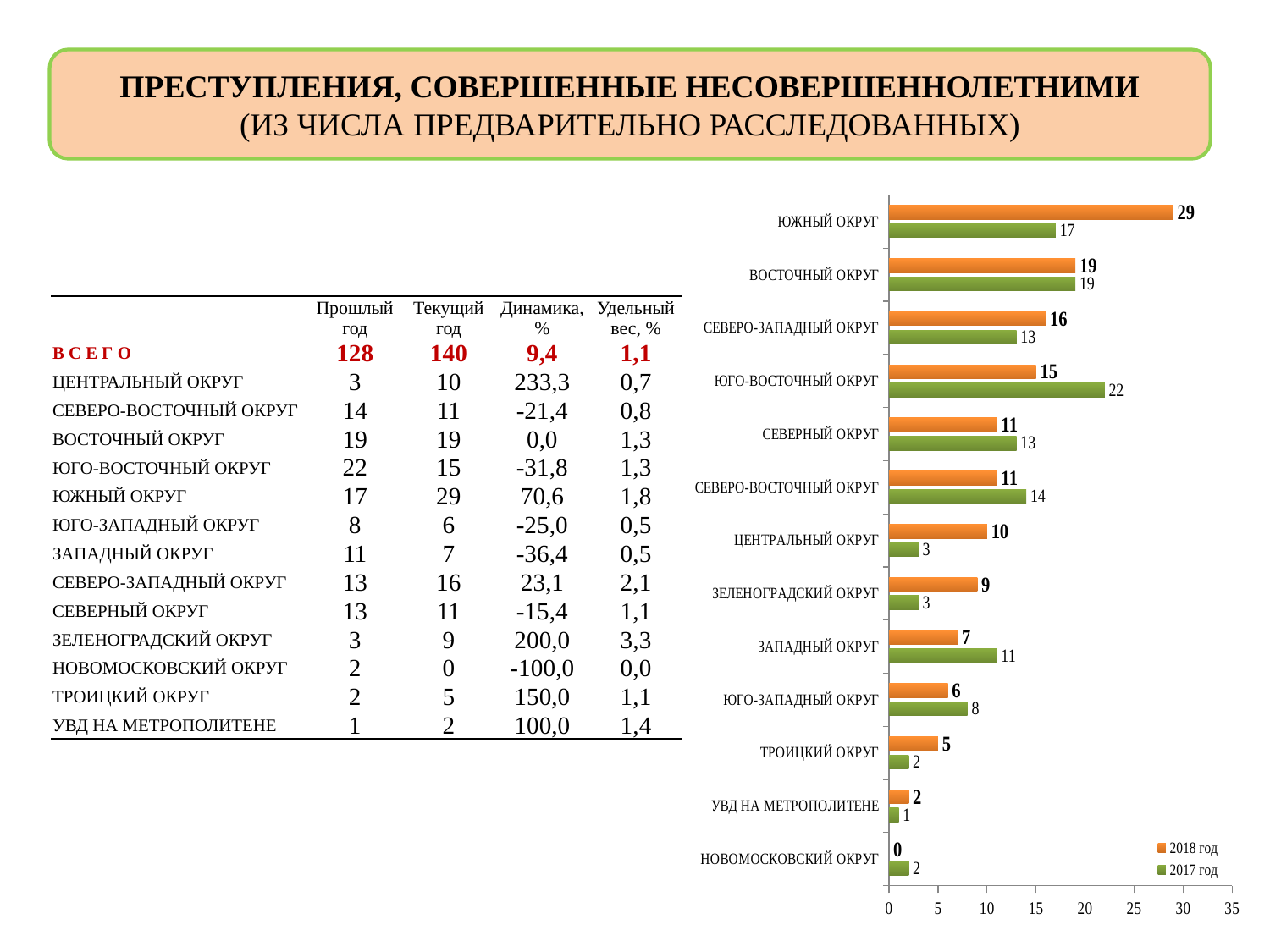
What type of chart is shown on the slide? bar chart How many categories are shown in the chart? 13 How many series does the chart legend list? 2 What is the 2017 год value for ЮГО-ВОСТОЧНЫЙ ОКРУГ in the chart? 22 Which category has the lowest 2018 год value in the chart? НОВОМОСКОВСКИЙ ОКРУГ For ЗАПАДНЫЙ ОКРУГ, which is larger: the 2018 год value or the 2017 год value? 2017 год What is the 2018 год value for ЮЖНЫЙ ОКРУГ in the chart? 29 What is the difference between the 2018 год and 2017 год values for ЮЖНЫЙ ОКРУГ? 12 Which category has the highest 2018 год value in the chart? ЮЖНЫЙ ОКРУГ Which colour represents the 2018 год series in the chart? orange What is the 2017 год value for ЦЕНТРАЛЬНЫЙ ОКРУГ in the chart? 3 Is the 2018 год value for СЕВЕРО-ЗАПАДНЫЙ ОКРУГ greater or less than 15? greater